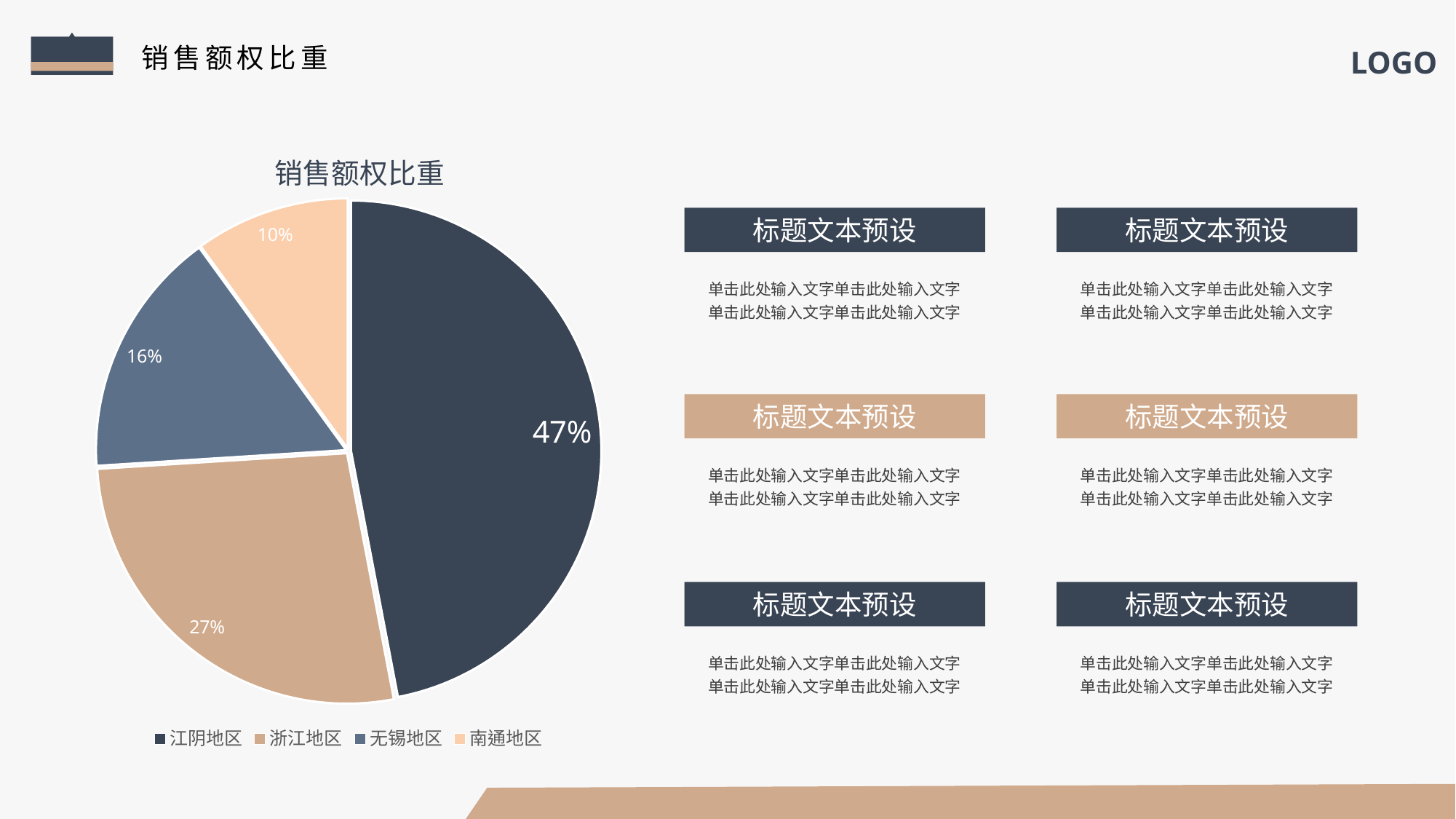
What share of the pie does 无锡地区 have? 16% Which region has the smallest slice of the pie? 南通地区 How many slices does the pie chart have? 4 Which region has the largest slice of the pie? 江阴地区 What is the title of the chart? 销售额权比重 What type of chart is shown on the slide? Pie chart What share of the pie does 江阴地区 have? 47% How many entries does the legend list? 4 What share of the pie does 浙江地区 have? 27% Which is larger, the share for 无锡地区 or the share for 南通地区? 无锡地区 What is the difference in percentage points between 江阴地区 and 浙江地区? 20